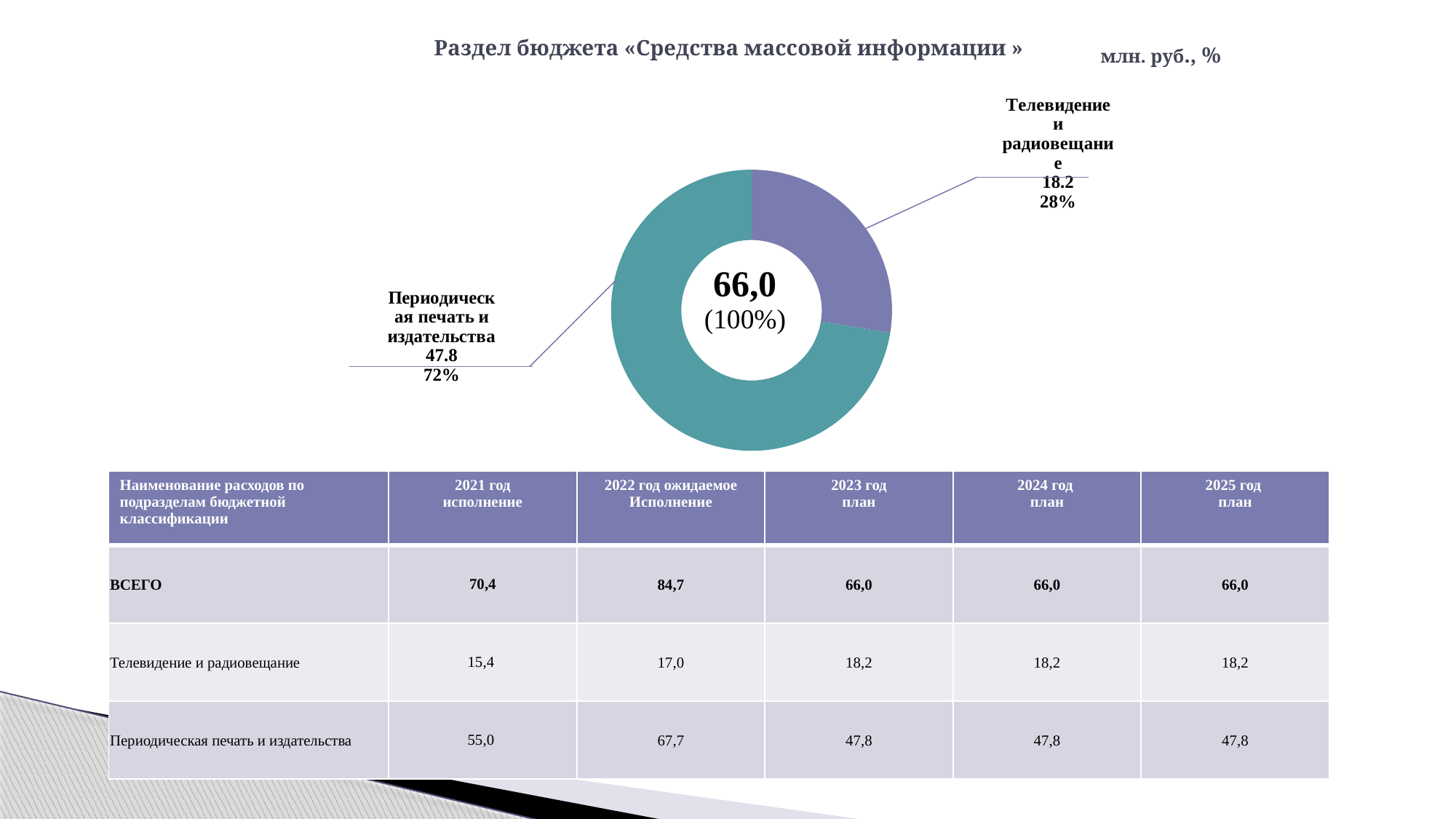
What units are indicated for the chart values on the slide? млн. руб., % What kind of chart is shown on the slide? Donut (pie) chart What share of the donut chart does «Периодическая печать и издательства» represent? 72% What is the difference between the values for «Периодическая печать и издательства» and «Телевидение и радиовещание» in the donut chart? 29.6 What is the value shown for «Телевидение и радиовещание» in the donut chart? 18.2 What is the title of the slide containing the donut chart? Раздел бюджета «Средства массовой информации » Which category has the smallest slice in the donut chart? Телевидение и радиовещание What total value is shown in the centre of the donut chart? 66,0 What share of the donut chart does «Телевидение и радиовещание» represent? 28% Which category has the largest slice in the donut chart? Периодическая печать и издательства How many slices does the donut chart have? 2 What is the value shown for «Периодическая печать и издательства» in the donut chart? 47.8